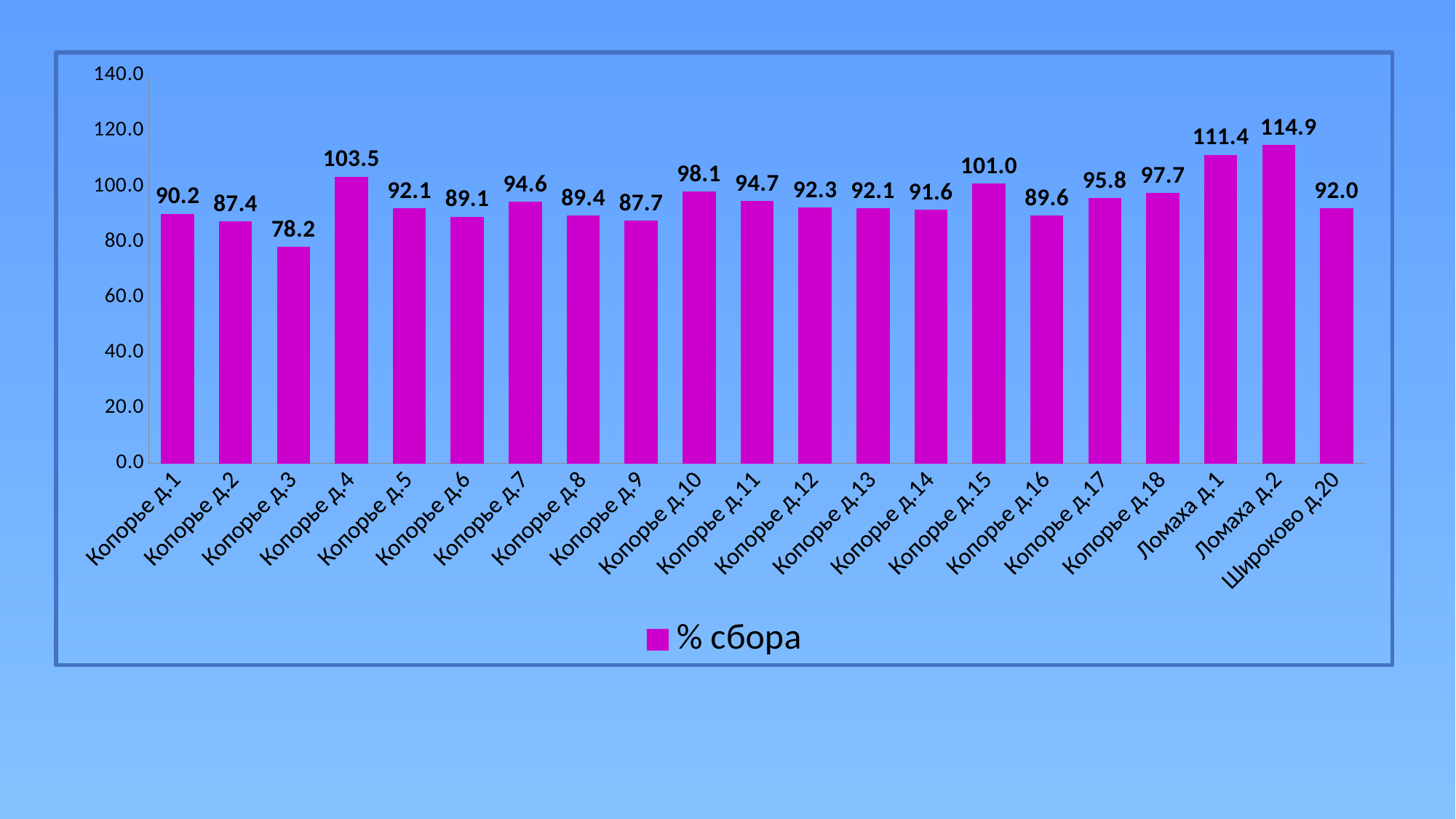
How many categories are shown on the x axis? 21 What is the difference between the values for Ломаха д.2 and Копорье д.3? 36.7 Which is larger, the value for Копорье д.10 or the value for Копорье д.15? Копорье д.15 What kind of chart is shown? bar chart What is the value for Широково д.20? 92.0 Which category has the highest value? Ломаха д.2 How many series does the legend list? 1 Which category has the lowest value? Копорье д.3 What is the value for Ломаха д.1? 111.4 What is the value for Копорье д.4? 103.5 Is the value for Копорье д.3 greater or less than 80.0? less What is the legend entry for the series? % сбора